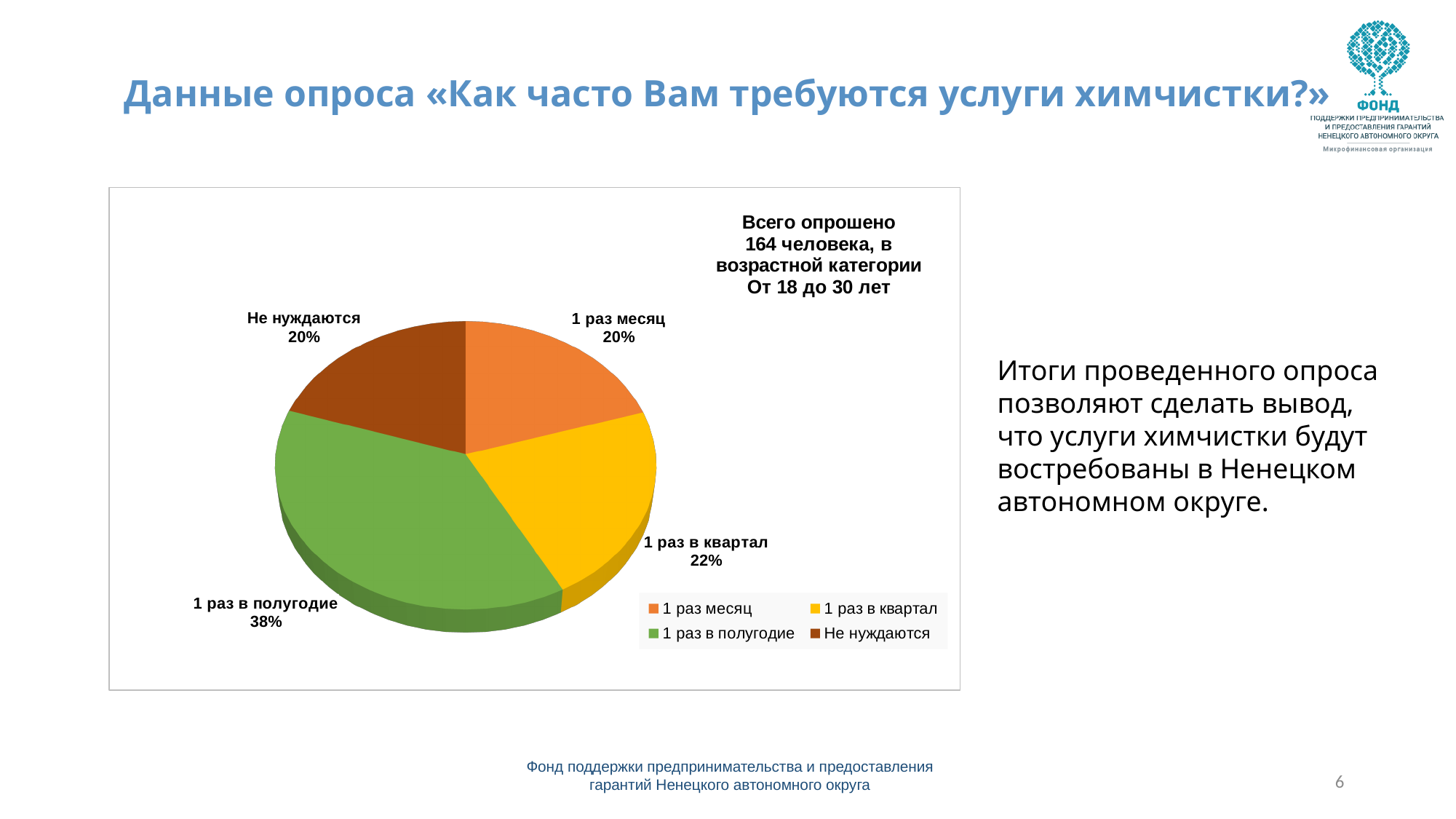
How many categories does the pie chart show? 4 Which category has the largest share of the pie? 1 раз в полугодие What kind of chart is shown on the slide? Pie chart What share of respondents answered «Не нуждаются»? 20% Which is larger: the share for «1 раз в квартал» or the share for «1 раз месяц»? 1 раз в квартал What share of respondents answered «1 раз месяц»? 20% How many entries does the legend list? 4 What is the difference in percentage points between «1 раз в полугодие» and «1 раз в квартал»? 16 What share of respondents answered «1 раз в квартал»? 22% What colour is the «1 раз в полугодие» slice? Green What share of respondents answered «1 раз в полугодие»? 38% How many people were surveyed according to the text on the chart? 164